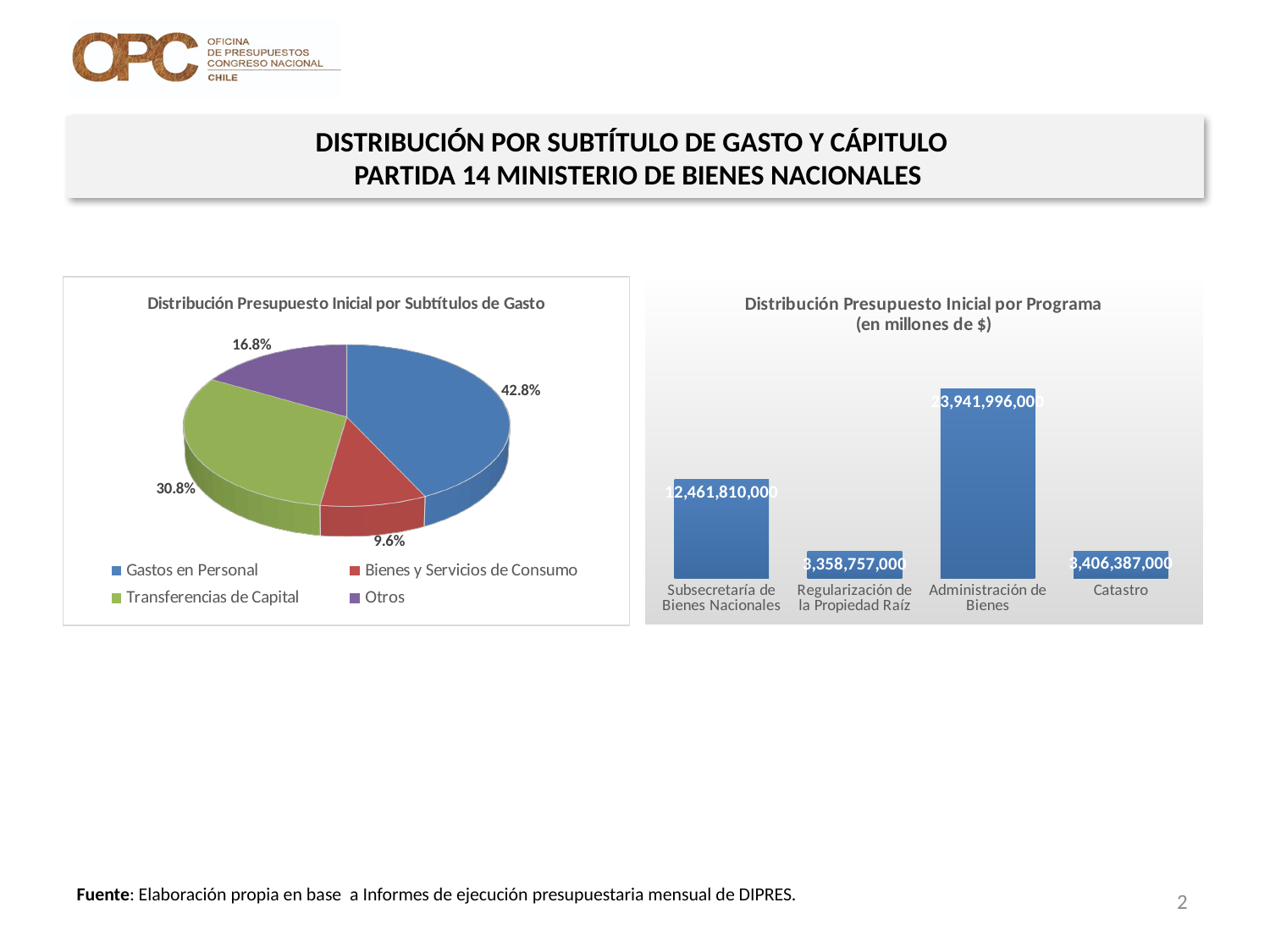
In the pie chart 'Distribución Presupuesto Inicial por Subtítulos de Gasto', what share does Gastos en Personal have? 42.8% In the pie chart 'Distribución Presupuesto Inicial por Subtítulos de Gasto', how many categories does the legend list? 4 In the pie chart 'Distribución Presupuesto Inicial por Subtítulos de Gasto', what is the difference in percentage points between Gastos en Personal and Transferencias de Capital? 12.0% In the bar chart 'Distribución Presupuesto Inicial por Programa', what is the value for Subsecretaría de Bienes Nacionales? 12,461,810,000 In the pie chart 'Distribución Presupuesto Inicial por Subtítulos de Gasto', which category has the smallest share? Bienes y Servicios de Consumo In the pie chart 'Distribución Presupuesto Inicial por Subtítulos de Gasto', which category has the largest share? Gastos en Personal In the bar chart 'Distribución Presupuesto Inicial por Programa', what is the difference between Administración de Bienes and Subsecretaría de Bienes Nacionales? 11,480,186,000 What type of chart is 'Distribución Presupuesto Inicial por Programa'? Bar chart In the bar chart 'Distribución Presupuesto Inicial por Programa', which program has the highest value? Administración de Bienes In the pie chart 'Distribución Presupuesto Inicial por Subtítulos de Gasto', what share does Transferencias de Capital have? 30.8% In the bar chart 'Distribución Presupuesto Inicial por Programa', what is the value for Administración de Bienes? 23,941,996,000 In the pie chart 'Distribución Presupuesto Inicial por Subtítulos de Gasto', what colour is the Otros slice? Purple